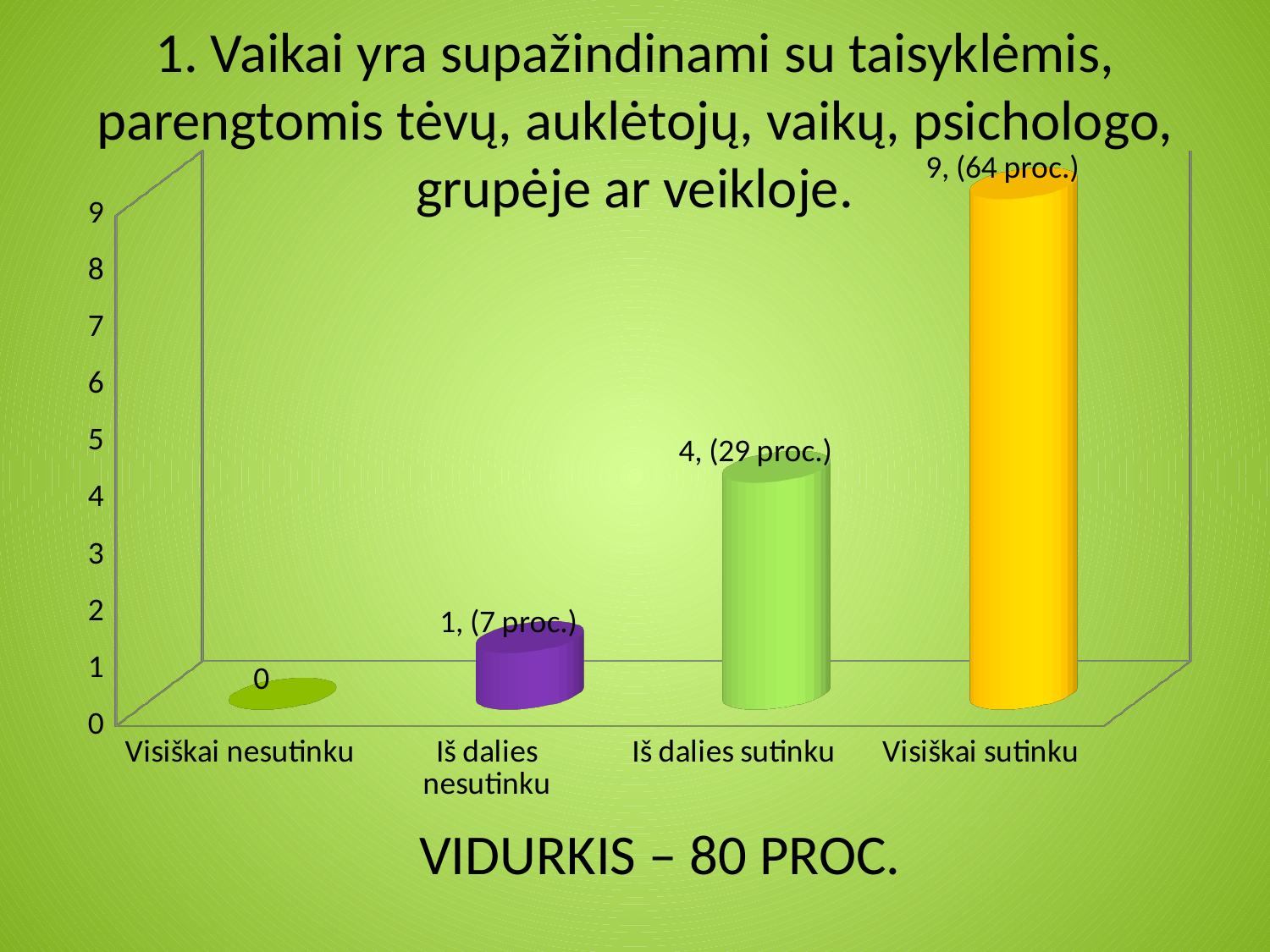
Which category has the highest value? Visiškai sutinku What kind of chart is shown on the slide? bar chart What average percentage is stated below the chart? 80 PROC. What is the data label for "Visiškai sutinku"? 9, (64 proc.) What is the data label for "Iš dalies sutinku"? 4, (29 proc.) What is the data label for "Iš dalies nesutinku"? 1, (7 proc.) What is the value for "Visiškai nesutinku"? 0 How many categories are shown on the x axis of the chart? 4 Do the values rise or fall moving from left to right along the x axis? rise Which category has the lowest value? Visiškai nesutinku What is the difference in count between "Visiškai sutinku" and "Iš dalies sutinku"? 5 Which is larger, the value for "Iš dalies sutinku" or the value for "Iš dalies nesutinku"? Iš dalies sutinku